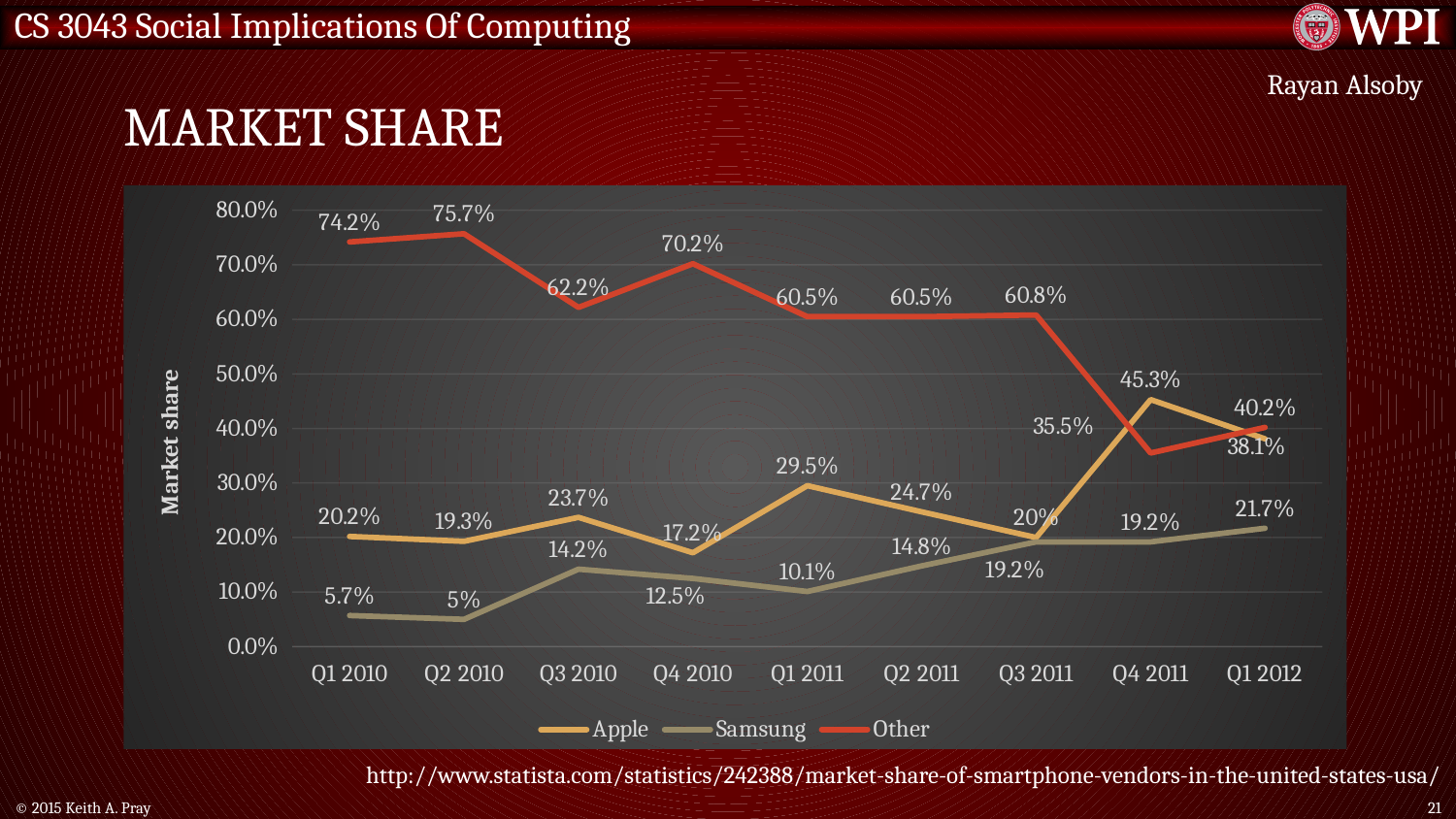
By how many percentage points did Apple's market share increase from Q3 2011 to Q4 2011? 25.3 percentage points What is Samsung's market share in Q1 2012? 21.7% In which quarter does the Other series reach its highest value? Q2 2010 How many quarters are plotted along the x axis? 9 What is the label on the vertical axis? Market share In which quarter is Samsung's market share lowest? Q2 2010 What is Apple's market share in Q4 2011? 45.3% In Q1 2012, which has the larger market share, Apple or Other? Other Does Samsung's market share generally rise or fall from Q1 2010 to Q1 2012? Rise What kind of chart is shown on the slide? Line chart What is the market share for Other in Q1 2010? 74.2% How many series does the legend list? 3